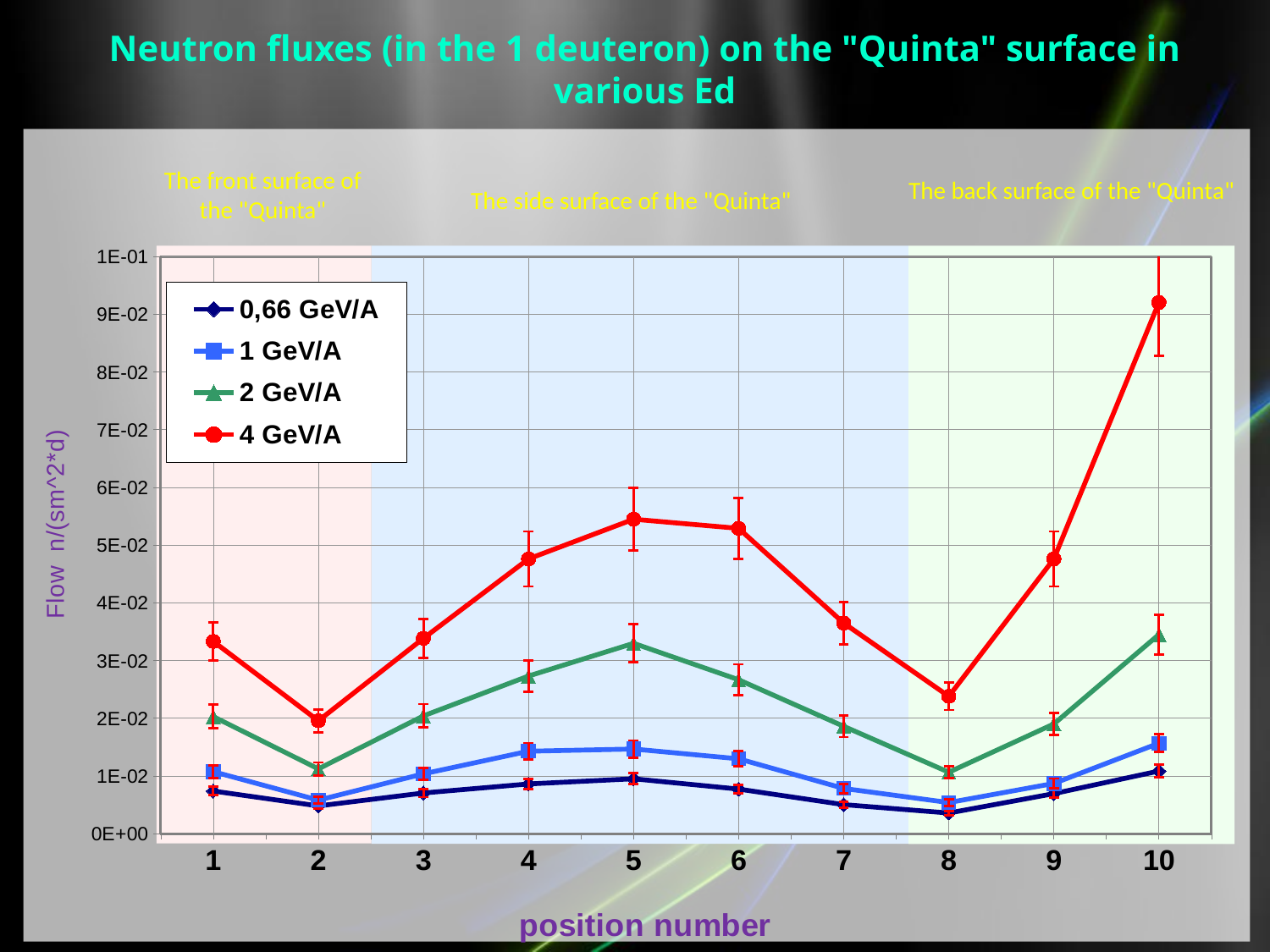
How many position numbers are plotted along the x axis? 10 Is the value for 0,66 GeV/A at position 8 greater or less than 1E-02? less What kind of chart is shown on the slide? line chart At position 5, which is larger: the 4 GeV/A value or the 2 GeV/A value? 4 GeV/A Which series has the lowest values across all positions? 0,66 GeV/A Is the value for 4 GeV/A at position 10 greater or less than 8E-02? greater What is the label of the x axis? position number How many series does the legend list? 4 Which series has the highest values across all positions? 4 GeV/A At which position number does the 4 GeV/A series have its lowest value? 2 Is the value for 4 GeV/A at position 5 greater or less than 5E-02? greater At which position number does the 4 GeV/A series reach its highest value? 10